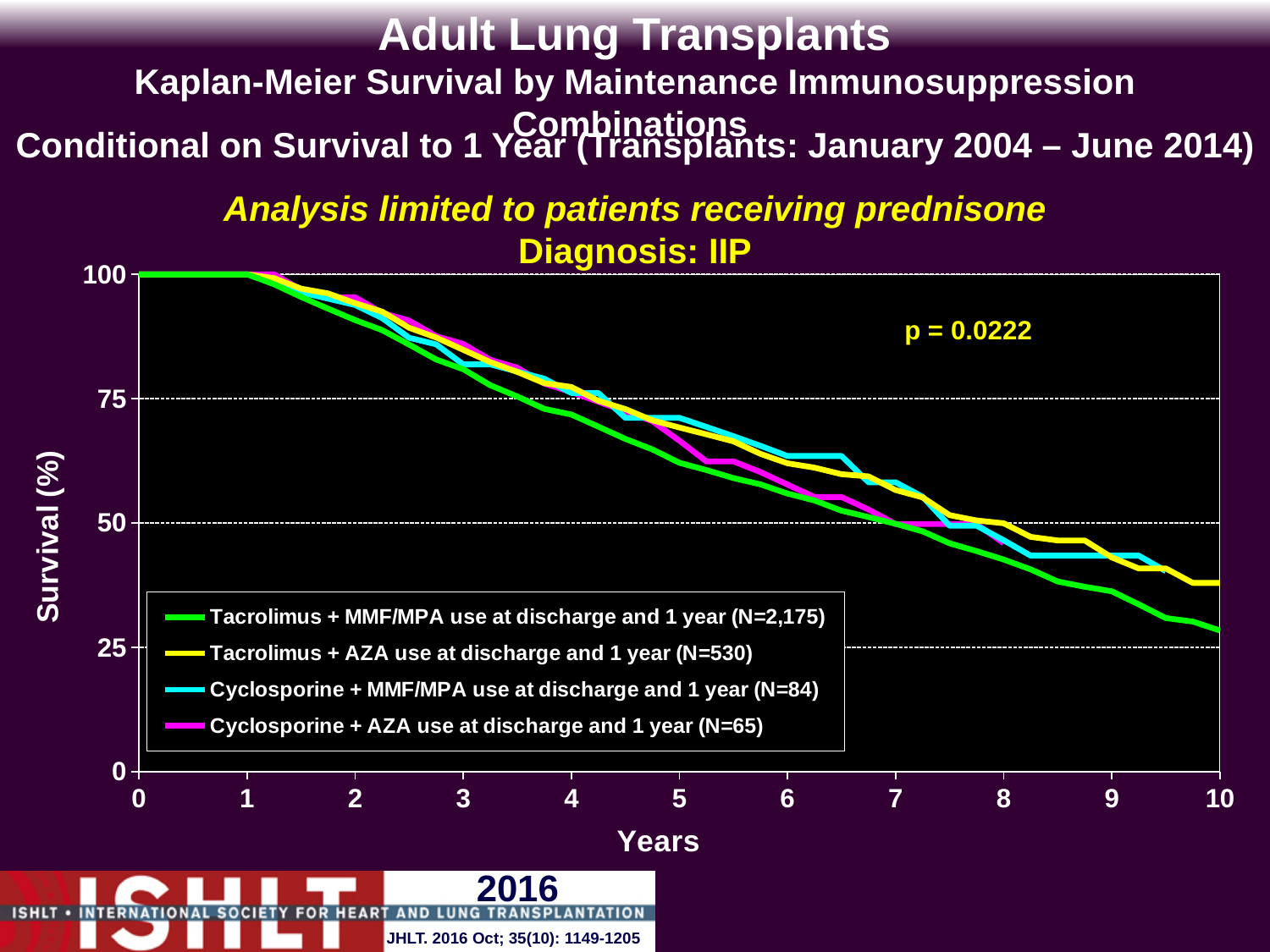
Is the survival value for Tacrolimus + MMF/MPA at year 10 greater or less than 50? less What p-value is shown on the chart? p = 0.0222 Is the survival value for Tacrolimus + AZA at year 10 greater or less than 50? less At year 10, which has higher survival: Tacrolimus + AZA or Tacrolimus + MMF/MPA? Tacrolimus + AZA How many series does the legend list? 4 Do the survival curves rise or fall as the years increase? fall What is the survival (%) for all four series at year 1? 100 What kind of chart is shown on the slide? line chart Is the survival value for Tacrolimus + MMF/MPA at year 5 greater or less than 50? greater What is the N for the Tacrolimus + MMF/MPA group in the legend? N=2,175 Which series has the lowest survival at year 10? Tacrolimus + MMF/MPA use at discharge and 1 year